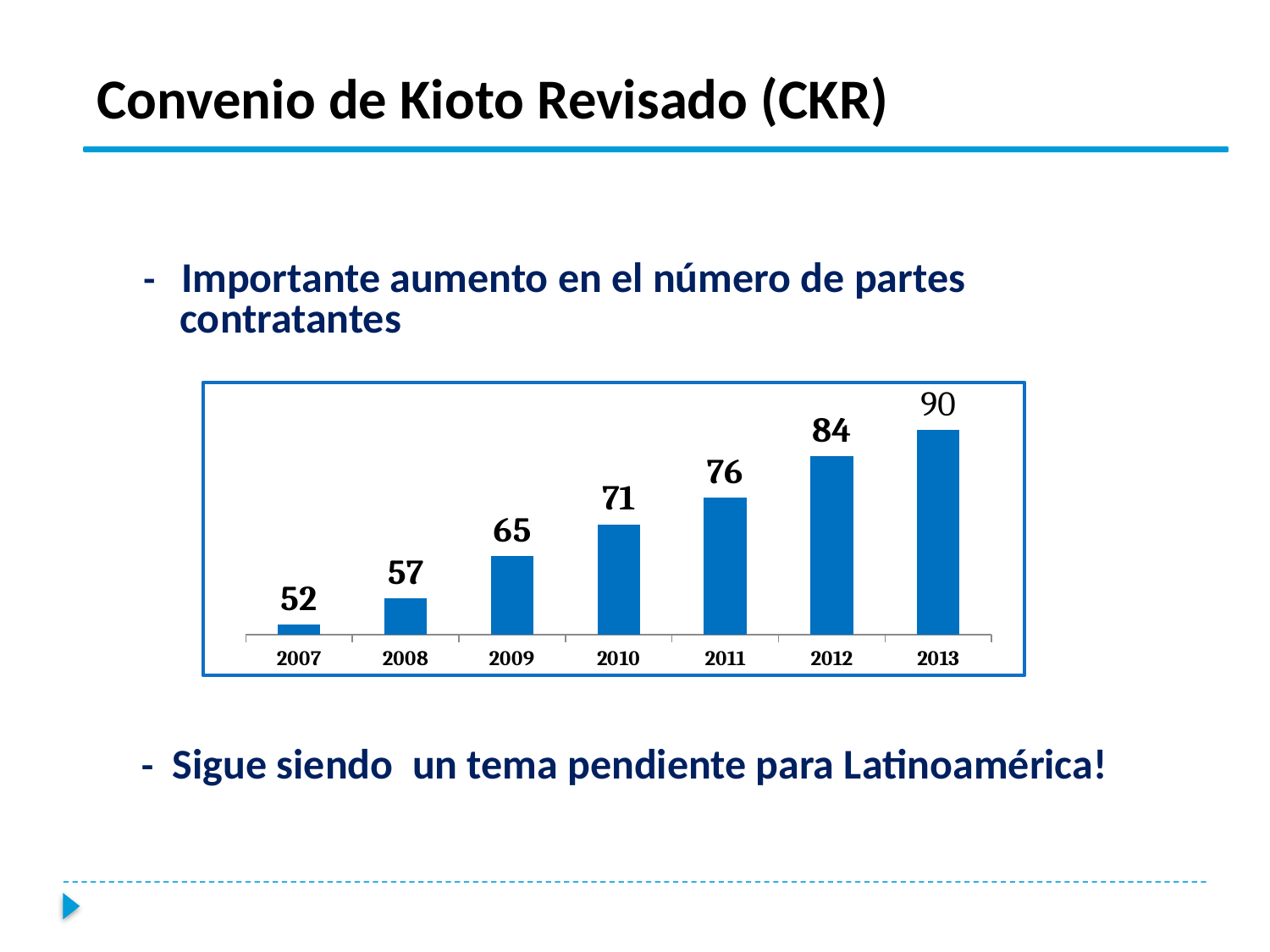
Which is larger, the value for 2009 or the value for 2011? 2011 What is the value for 2007? 52 Which year has the highest value? 2013 Which year has the lowest value? 2007 What is the value for 2010? 71 What kind of chart is shown? bar chart What is the difference between the values for 2012 and 2011? 8 How many years are shown on the x axis? 7 What colour are the bars in the chart? blue What is the difference between the values for 2013 and 2007? 38 Do the values rise or fall from 2007 to 2013? rise What is the value for 2013? 90